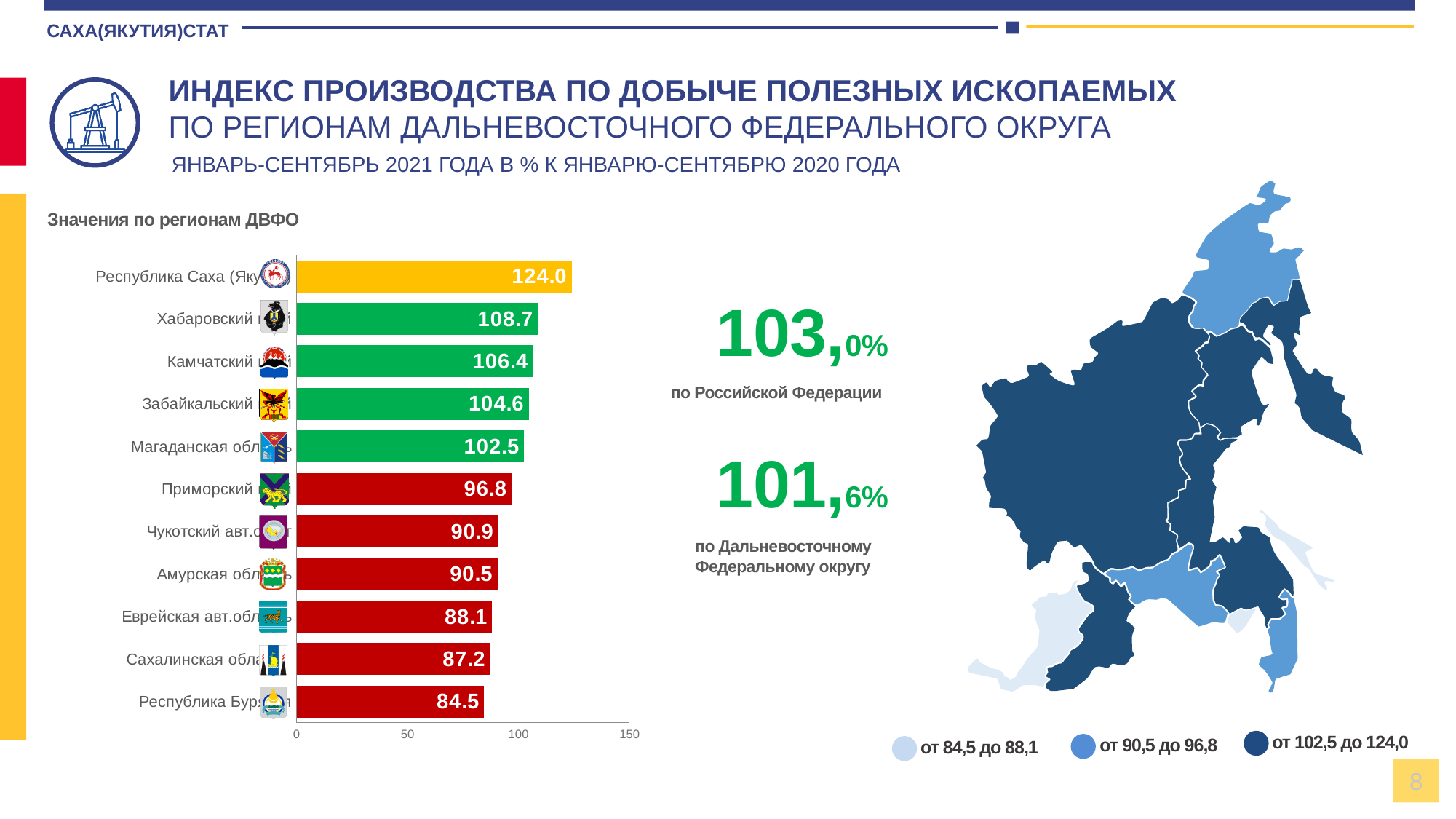
What colour is the bar for Республика Саха (Якутия)? yellow Is the value for Амурская область greater or less than 100? less What is the difference between the values for Хабаровский край and Камчатский край? 2.3 How many regions are shown in the bar chart? 11 Which region has the highest value in the bar chart? Республика Саха (Якутия) What is the value for Республика Саха (Якутия) in the bar chart? 124.0 What is the value for Сахалинская область in the bar chart? 87.2 Which has a larger value, Приморский край or Чукотский авт.округ? Приморский край What is the value for Магаданская область in the bar chart? 102.5 Which region has the lowest value in the bar chart? Республика Бурятия What kind of chart is used to show the values by region? bar chart What is the difference between the values for Республика Саха (Якутия) and Республика Бурятия? 39.5